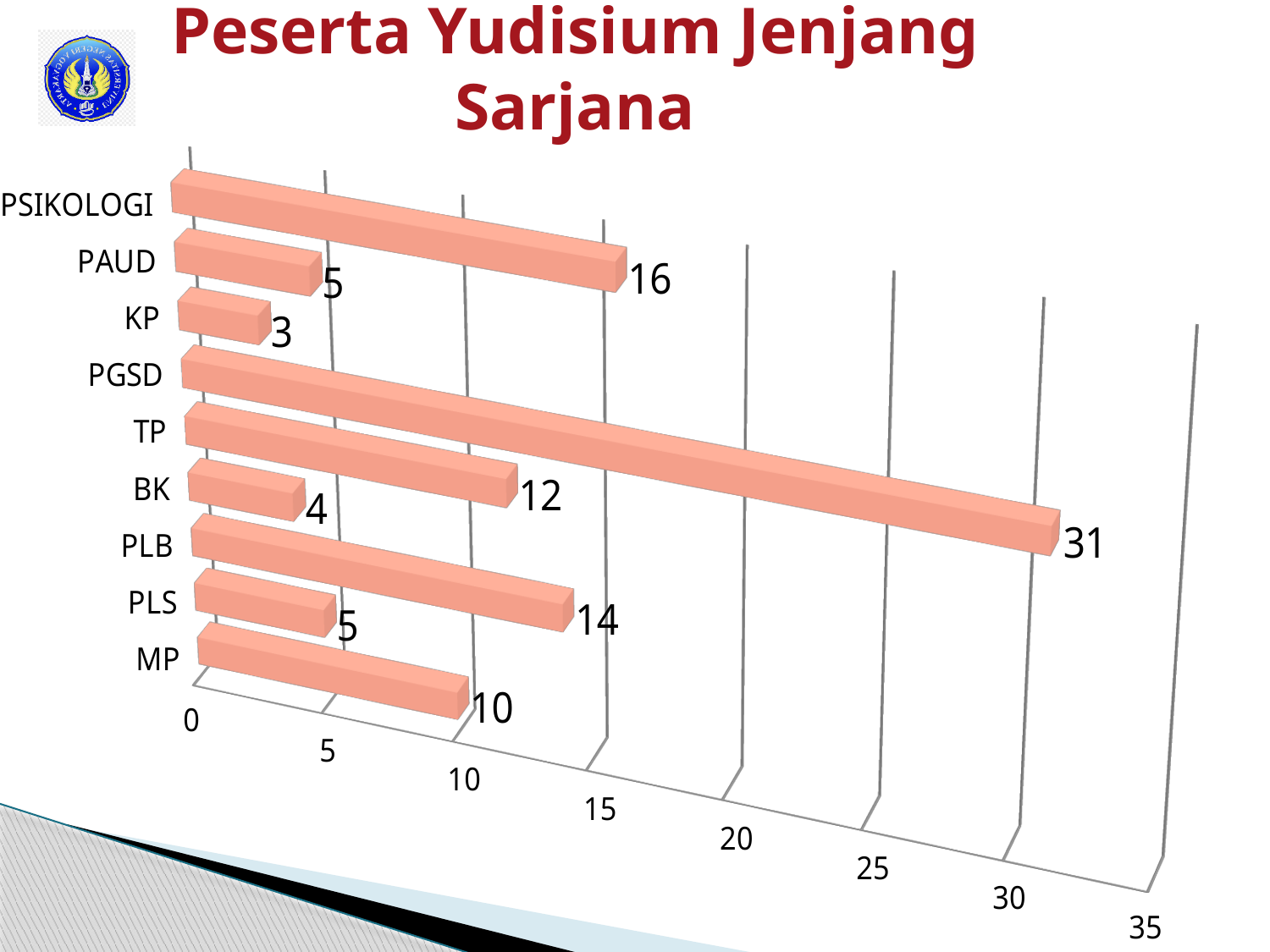
Is the value for PGSD greater or less than 25? greater What is the value for MP? 10 Which category has the lowest value? KP What is the value for PSIKOLOGI? 16 Which is larger, the value for TP or the value for PLB? PLB What is the value for PGSD? 31 How many categories are shown in the chart? 9 Which category has the highest value? PGSD What is the value for PLB? 14 What is the difference between the values for PGSD and PSIKOLOGI? 15 What is the title of the chart? Peserta Yudisium Jenjang Sarjana What kind of chart is shown on the slide? Bar chart